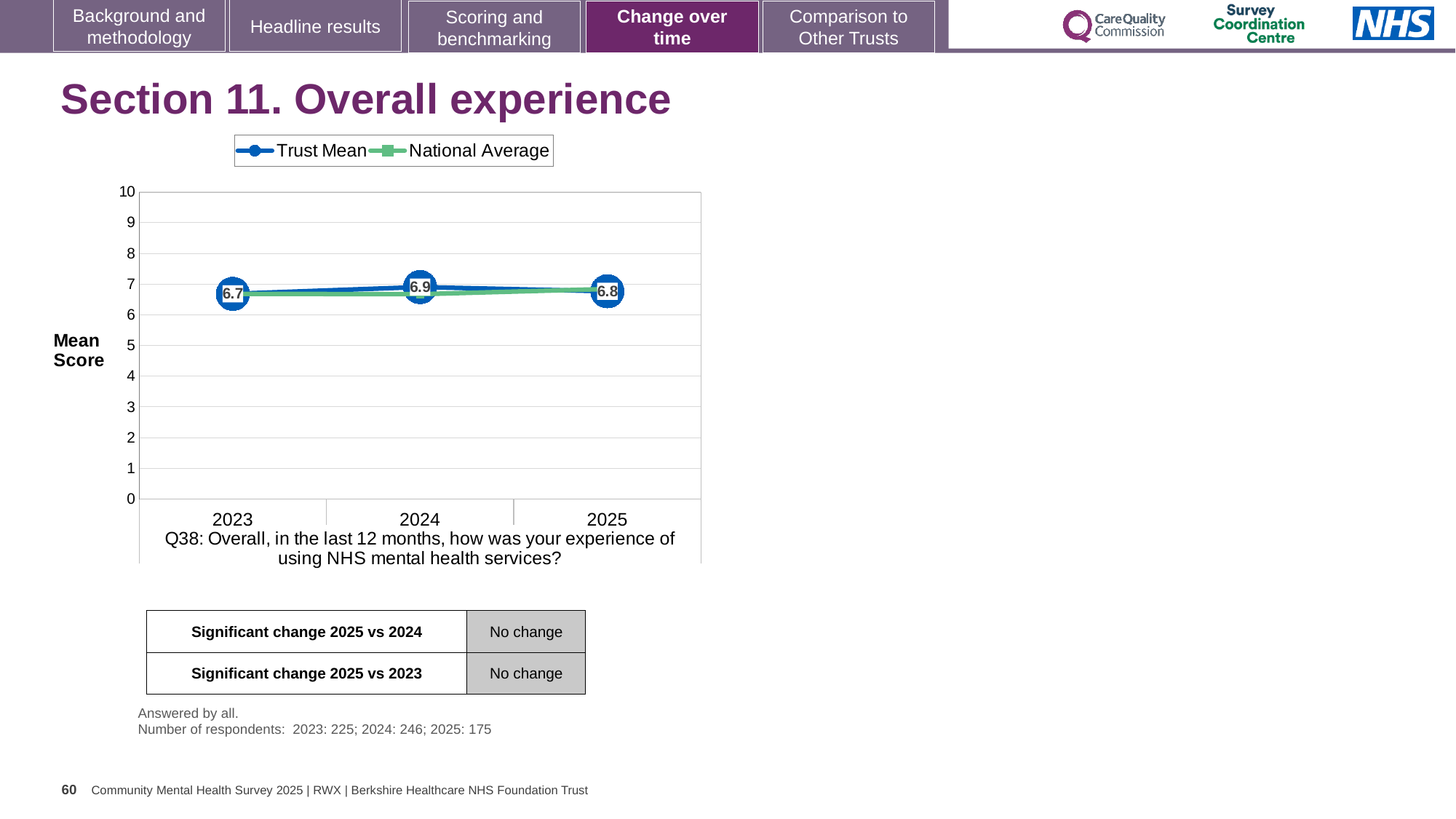
How many series does the legend list? 2 What kind of chart is shown on the slide? Line chart What is the Trust Mean value for 2023? 6.7 What is the difference between the Trust Mean in 2024 and in 2023? 0.2 Is the National Average value for 2024 greater or less than 5? greater What is the Trust Mean value for 2024? 6.9 Which year has the larger Trust Mean, 2024 or 2025? 2024 In which year is the Trust Mean lowest? 2023 What is the Trust Mean value for 2025? 6.8 Does the Trust Mean rise or fall from 2023 to 2024? Rise In which year is the Trust Mean highest? 2024 How many years are plotted on the x axis? 3